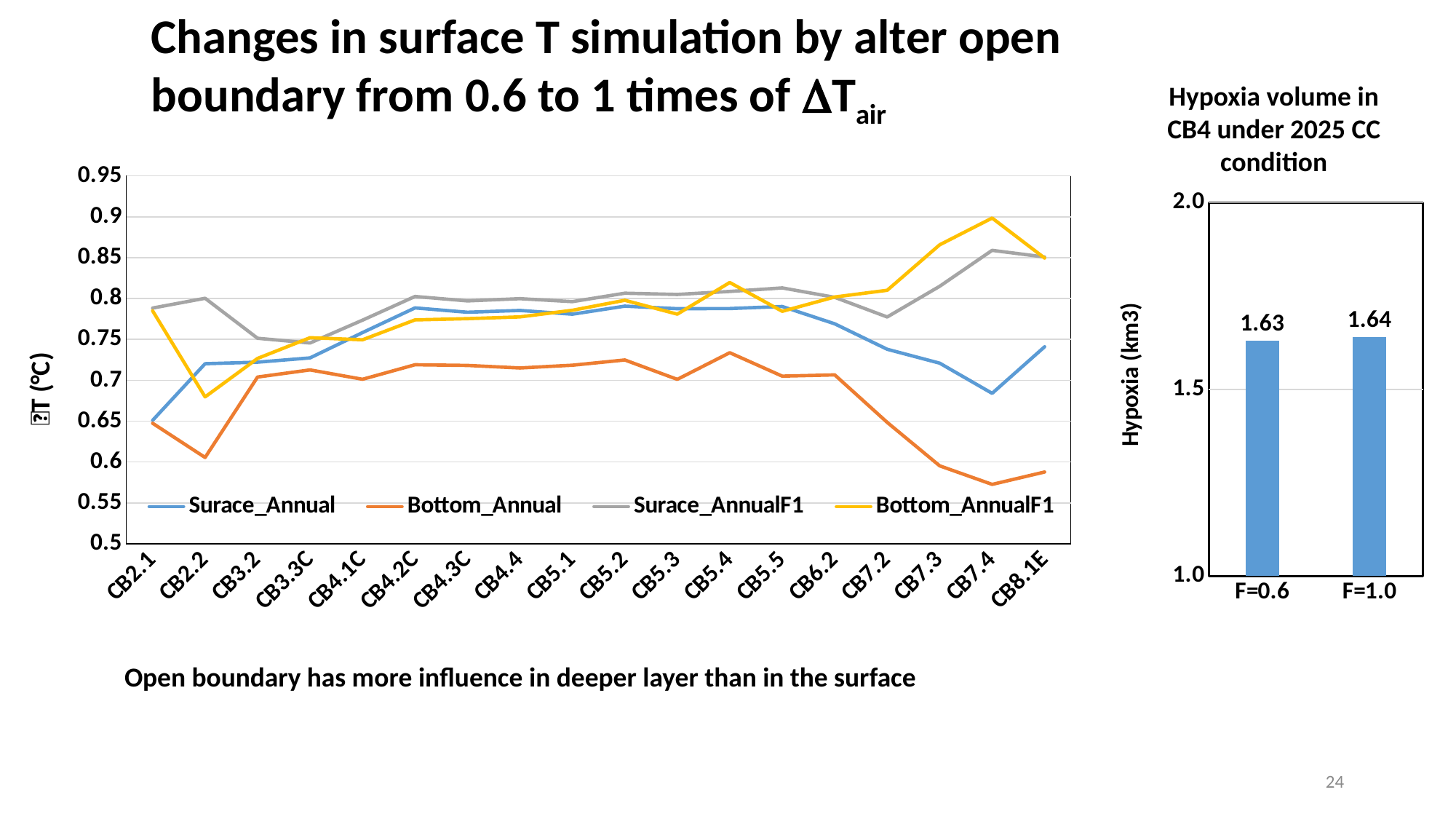
In the line chart on the left, at CB7.4, which series has the higher value: Surace_Annual or Bottom_Annual? Surace_Annual In the line chart on the left, how many series does the legend list? 4 In the bar chart titled 'Hypoxia volume in CB4 under 2025 CC condition', how many bars are plotted? 2 In the line chart on the left, how many categories are shown on the x axis? 18 In the line chart on the left, is the value of Bottom_Annual at CB2.2 greater or less than 0.65? less In the line chart on the left, is the value of Bottom_AnnualF1 at CB7.4 greater or less than 0.85? greater What kind of chart is the large chart on the left side of the slide? Line chart What kind of chart is the chart on the right side of the slide? Bar chart In the bar chart titled 'Hypoxia volume in CB4 under 2025 CC condition', what is the value for F=1.0? 1.64 In the bar chart titled 'Hypoxia volume in CB4 under 2025 CC condition', what is the value for F=0.6? 1.63 In the bar chart titled 'Hypoxia volume in CB4 under 2025 CC condition', what is the difference between the values for F=1.0 and F=0.6? 0.01 In the bar chart titled 'Hypoxia volume in CB4 under 2025 CC condition', what is the y-axis label? Hypoxia (km3)